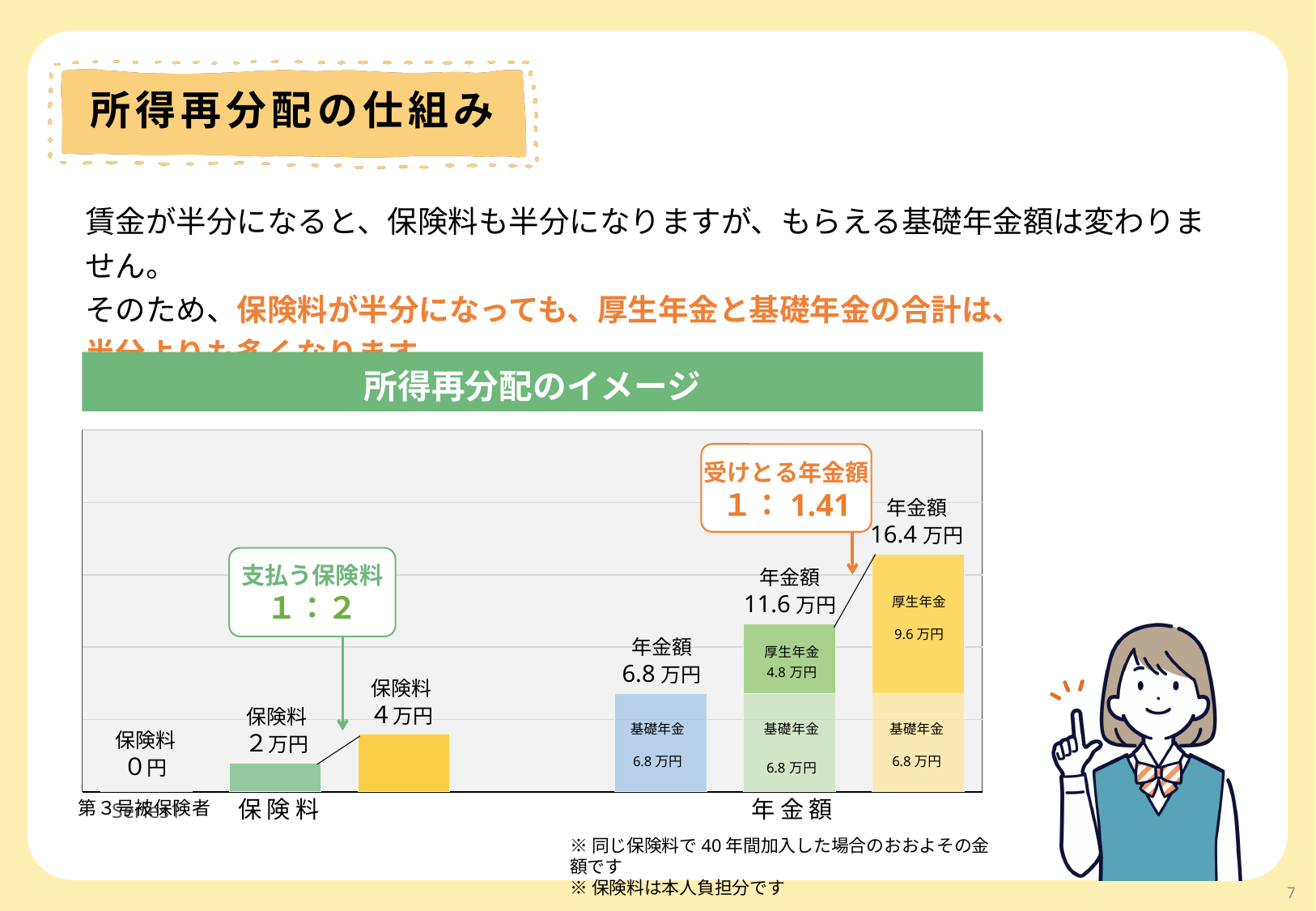
What is the 厚生年金 portion of the rightmost bar in the 年金額 group (年金額 16.4万円)? 9.6万円 What ratio is shown in the box labeled 受けとる年金額? 1：1.41 What is the 厚生年金 portion of the middle bar in the 年金額 group (年金額 11.6万円)? 4.8万円 What type of chart is shown under the title 所得再分配のイメージ? bar chart What is the 保険料 value for the first (leftmost) bar in the 保険料 group? 0円 What is the 保険料 value for the middle bar in the 保険料 group? 2万円 What is the difference between the 年金額 of the rightmost bar (16.4万円) and the middle bar (11.6万円)? 4.8万円 What is the total 年金額 of the rightmost stacked bar? 16.4万円 What is the 保険料 value for the rightmost bar in the 保険料 group? 4万円 What ratio is shown in the box labeled 支払う保険料? 1：2 Which bar in the 年金額 group is the highest? the rightmost bar (16.4万円) What is the 年金額 for the leftmost bar in the 年金額 group? 6.8万円